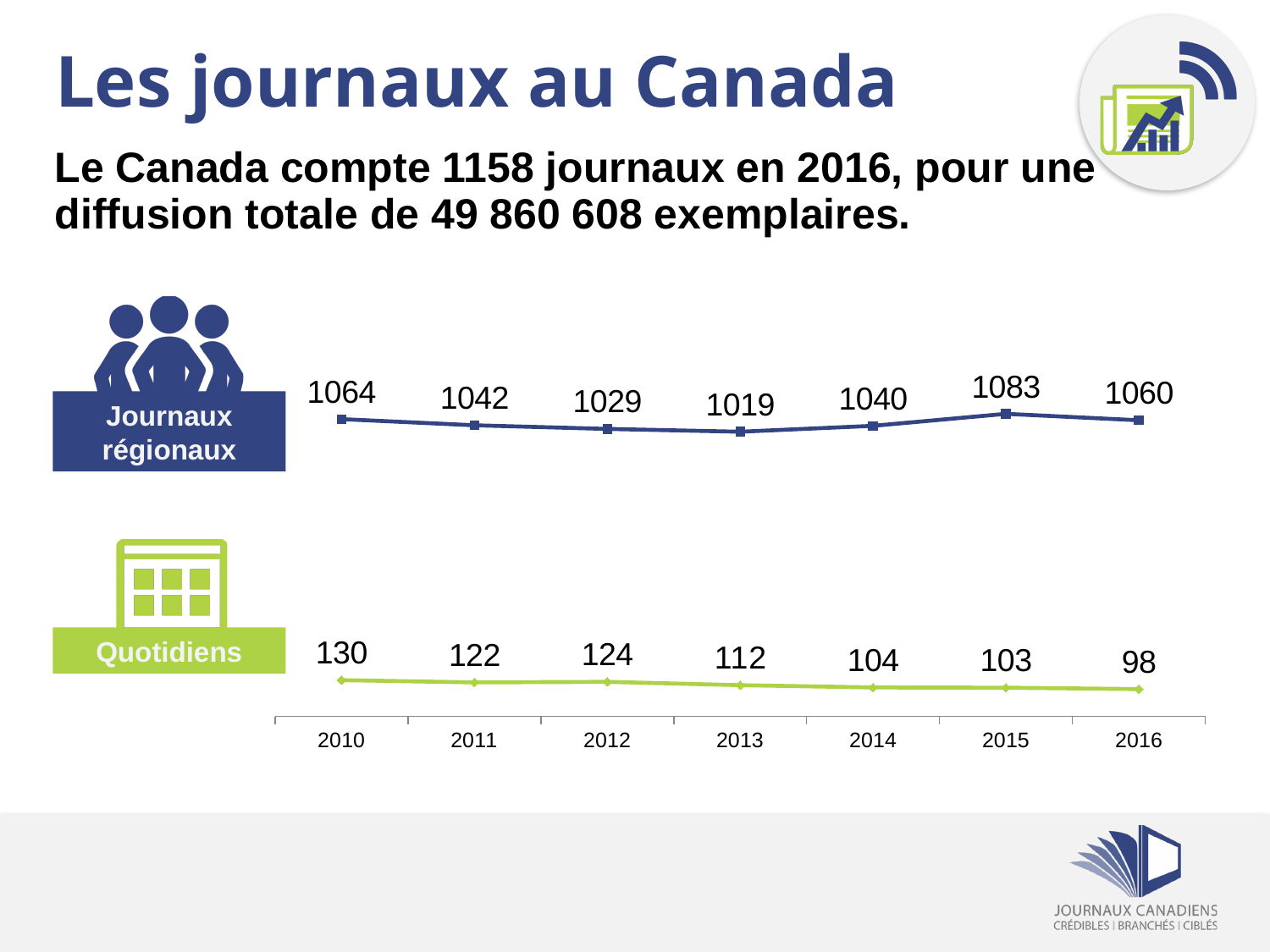
In the Quotidiens chart, do the values generally rise or fall from 2010 to 2016? Fall In the Quotidiens chart, what is the difference between the 2010 value and the 2016 value? 32 In the Quotidiens chart, what is the value for 2016? 98 In the Journaux régionaux chart, what is the value for 2013? 1019 How many years are plotted in the Quotidiens chart? 7 In the Journaux régionaux chart, what is the difference between the 2015 value and the 2013 value? 64 In the Journaux régionaux chart, which is larger, the value for 2010 or the value for 2016? 2010 What kind of chart is used for the Quotidiens data? Line chart In the Quotidiens chart, which year has the highest value? 2010 In the Quotidiens chart, which year has the lowest value? 2016 In the Journaux régionaux chart, which year has the highest value? 2015 In the Quotidiens chart, which is larger, the value for 2011 or the value for 2012? 2012